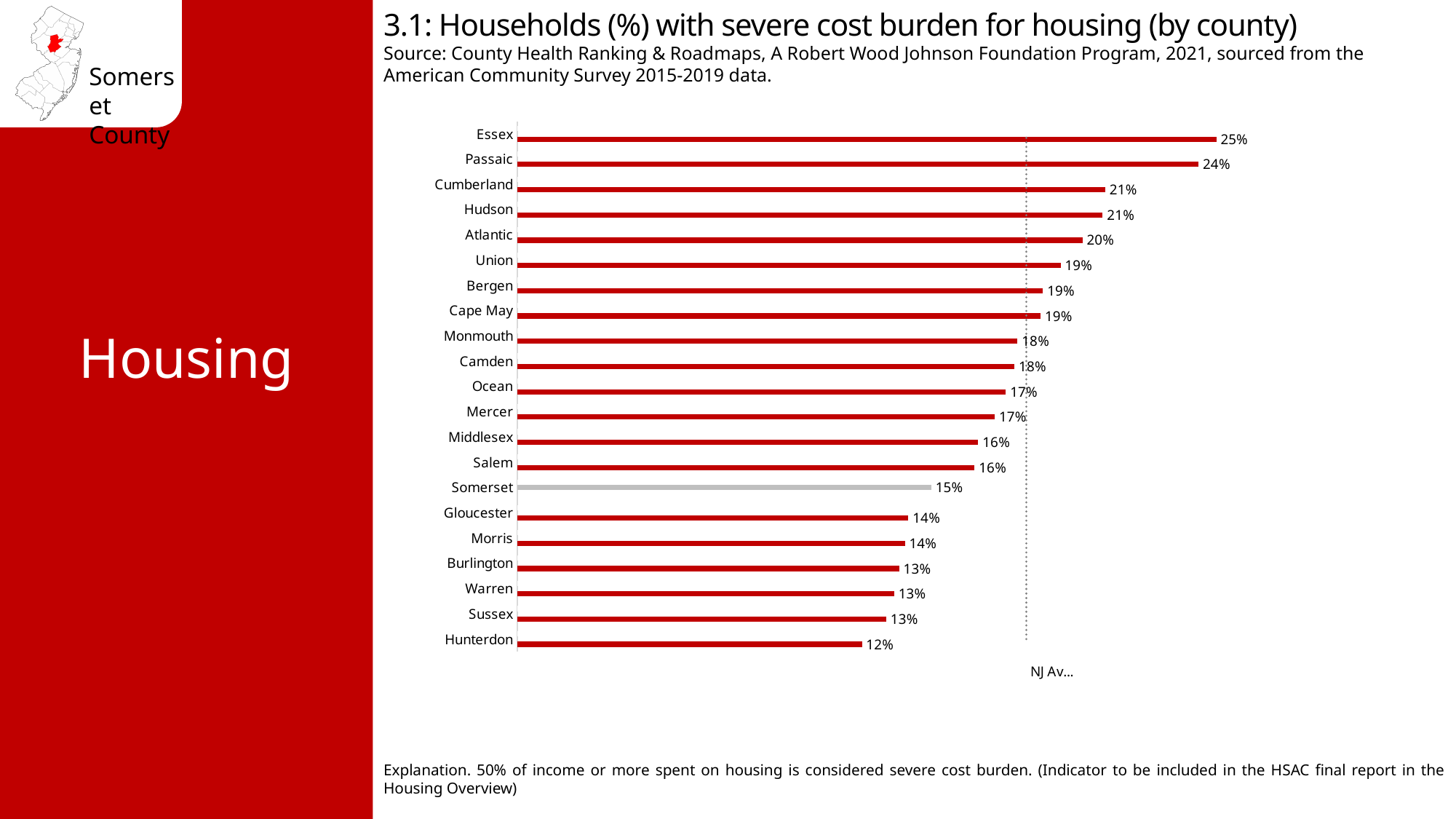
What is the value shown for Hudson County? 21% What is the value shown for Gloucester County? 14% What kind of chart is used on this slide? Bar chart What percentage of households in Somerset County have a severe housing cost burden? 15% Which has a higher value, Somerset or Morris? Somerset What is the difference between the values for Passaic and Hunterdon? 12 percentage points Which county has the highest percentage of households with severe housing cost burden? Essex How many counties are shown in the chart? 21 Which county has the lowest percentage of households with severe housing cost burden? Hunterdon Do the values rise or fall going from the top bar (Essex) to the bottom bar (Hunterdon)? Fall How many percentage points higher is Essex County's value than Somerset County's value? 10 percentage points Which county's bar is coloured grey instead of red? Somerset